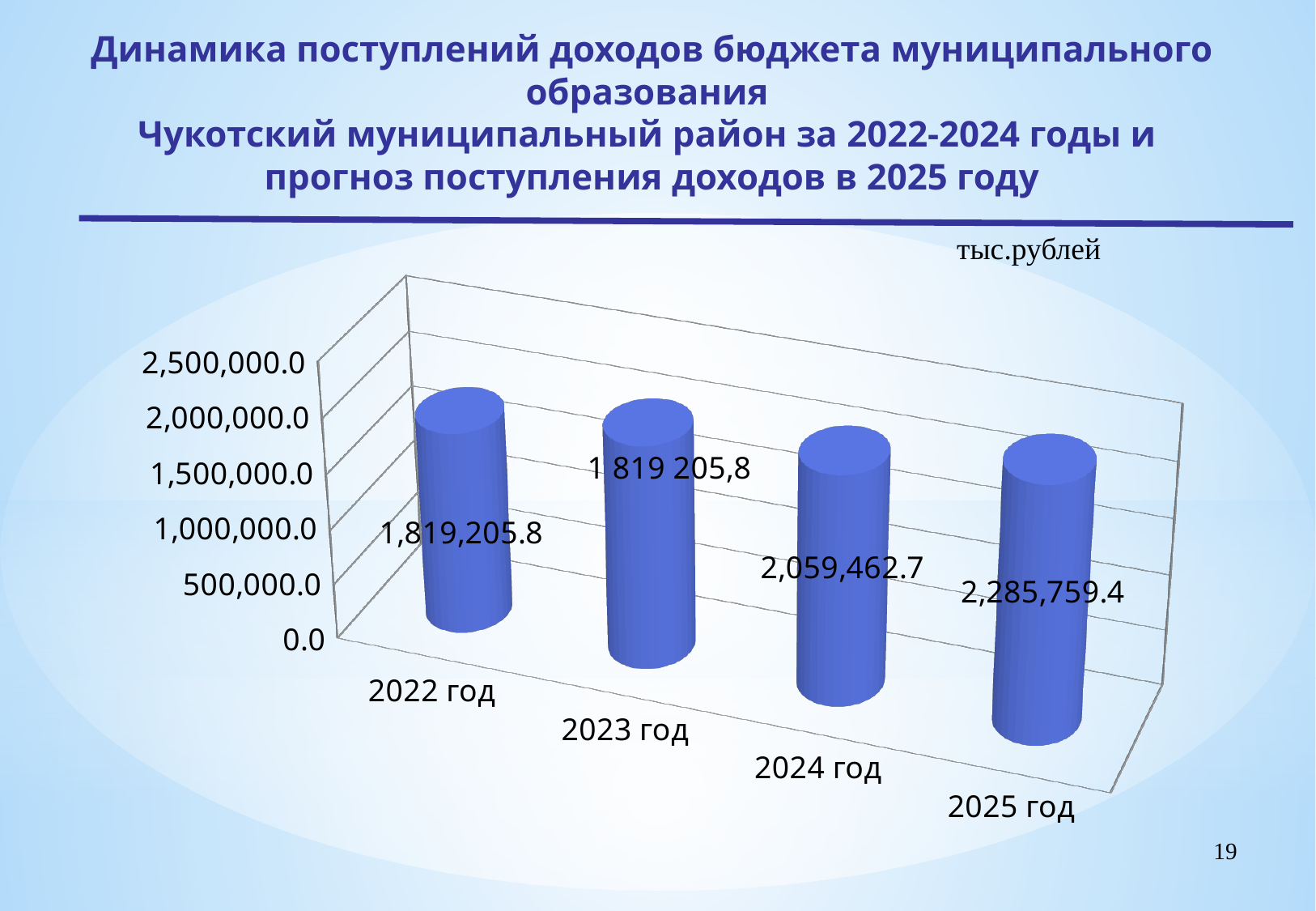
What is the value for 2022 год? 1,819,205.8 What is the value for 2024 год? 2,059,462.7 What is the value for 2025 год? 2,285,759.4 Do the values rise or fall from 2022 год to 2025 год? rise Is the value for 2025 год greater or less than 2,000,000.0? greater Which is larger, the value for 2024 год or 2022 год? 2024 год What is the difference between the values for 2024 год and 2022 год? 240,256.9 What kind of chart is shown on the slide? bar chart What is the difference between the values for 2025 год and 2024 год? 226,296.7 Which year has the highest value? 2025 год How many years are shown on the chart? 4 Is the value for 2022 год greater or less than 2,000,000.0? less